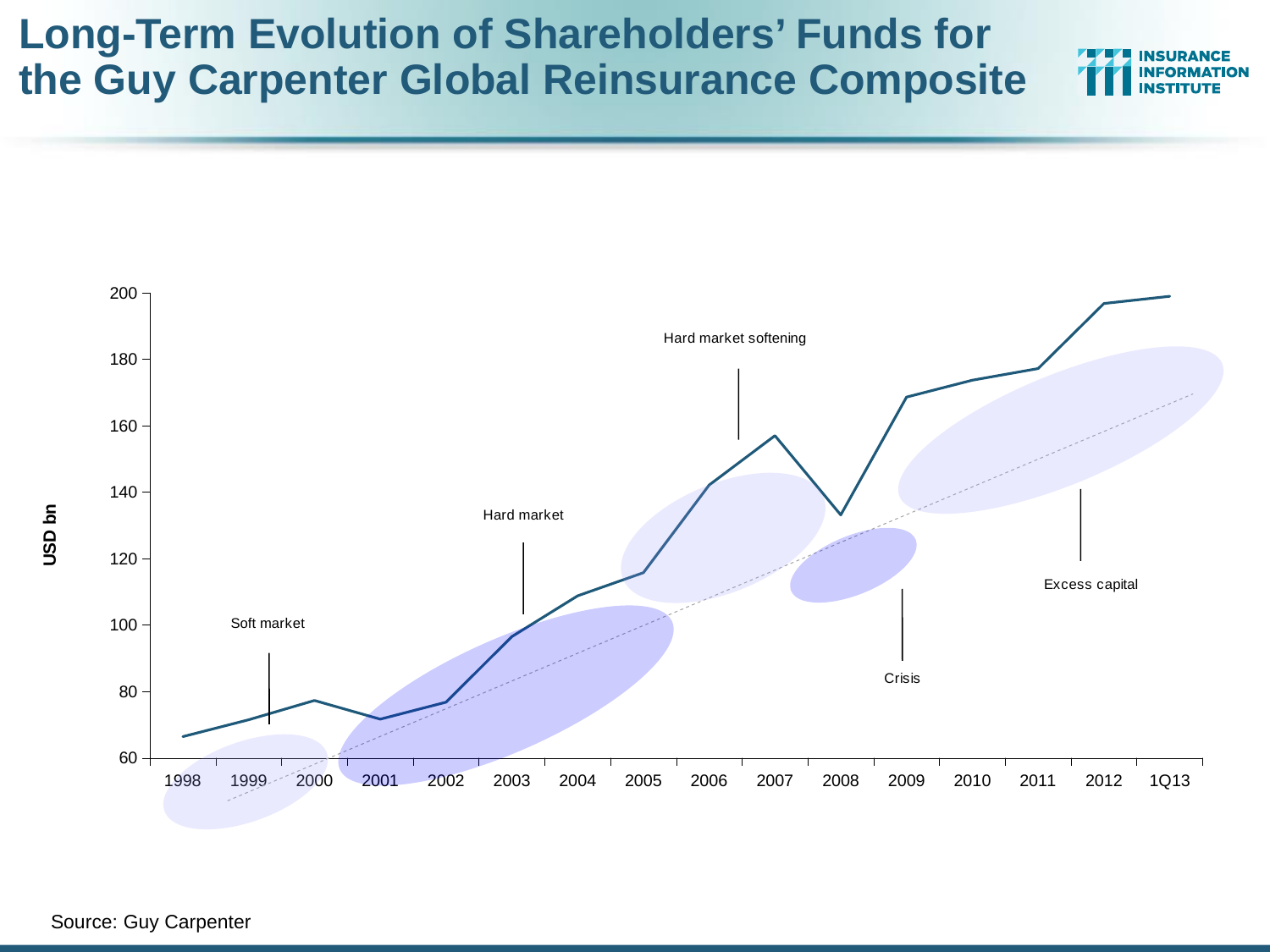
What annotation is placed near the 2008 dip in the line? Crisis Is the value for 2009 greater or less than 160? greater Is the value for 2012 greater or less than 180? greater How many time points are plotted along the x axis? 16 Do the values generally rise or fall from 1998 to 1Q13? rise Which year has the lowest value of shareholders' funds? 1998 Is the value for 2001 greater or less than 80? less Which is larger, the value for 2007 or the value for 2008? 2007 What is the label on the y axis? USD bn What kind of chart is shown on the slide? line chart